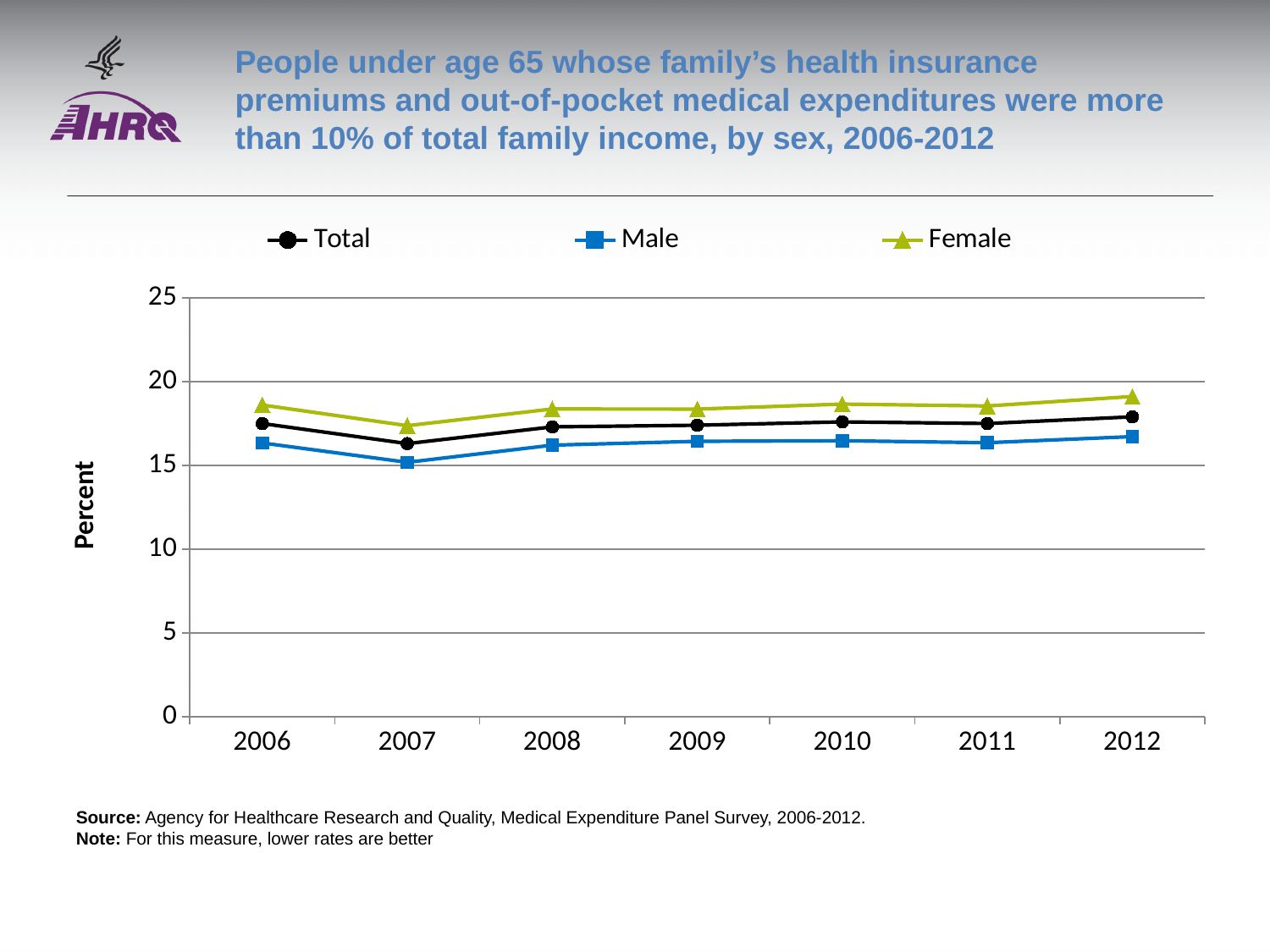
Is the Male value for 2006 greater or less than 15? greater In which year is the Female series at its highest? 2012 How many years are plotted along the x axis? 7 What kind of chart is shown on the slide? line chart What is the label on the y axis? Percent Which is larger, the Male value in 2007 or the Male value in 2012? 2012 Is the Female value for 2012 greater or less than 20? less In which year is the Female series at its lowest? 2007 In 2010, which is larger, the Female value or the Male value? Female How many series does the legend list? 3 Does the Male series rise or fall from 2007 to 2012? rise In which year is the Male series at its lowest? 2007